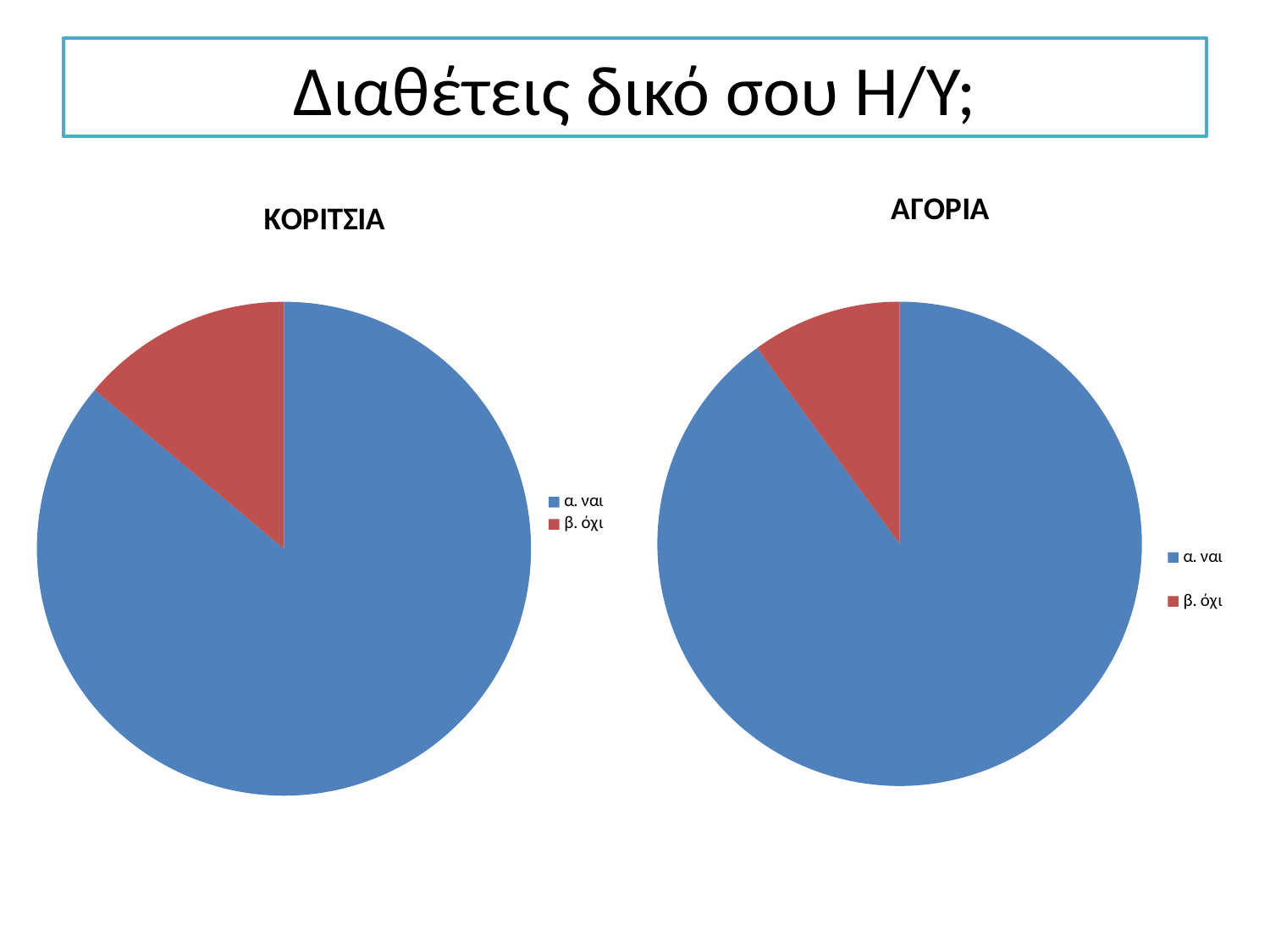
What is the title of the chart on the left? ΚΟΡΙΤΣΙΑ How many entries does the legend of the ΑΓΟΡΙΑ chart list? 2 How many slices does the ΚΟΡΙΤΣΙΑ pie chart have? 2 In the ΚΟΡΙΤΣΙΑ chart, which category has the largest slice? α. ναι In the ΑΓΟΡΙΑ chart, which slice is larger, α. ναι or β. όχι? α. ναι In the ΑΓΟΡΙΑ chart, which category has the smallest slice? β. όχι What kind of chart is the ΑΓΟΡΙΑ chart? pie chart Which chart has the larger β. όχι slice, ΚΟΡΙΤΣΙΑ or ΑΓΟΡΙΑ? ΚΟΡΙΤΣΙΑ In the ΚΟΡΙΤΣΙΑ chart, which category has the smallest slice? β. όχι What kind of chart is the ΚΟΡΙΤΣΙΑ chart? pie chart In the ΑΓΟΡΙΑ chart, what colour is the β. όχι slice? red In the ΑΓΟΡΙΑ chart, which category has the largest slice? α. ναι